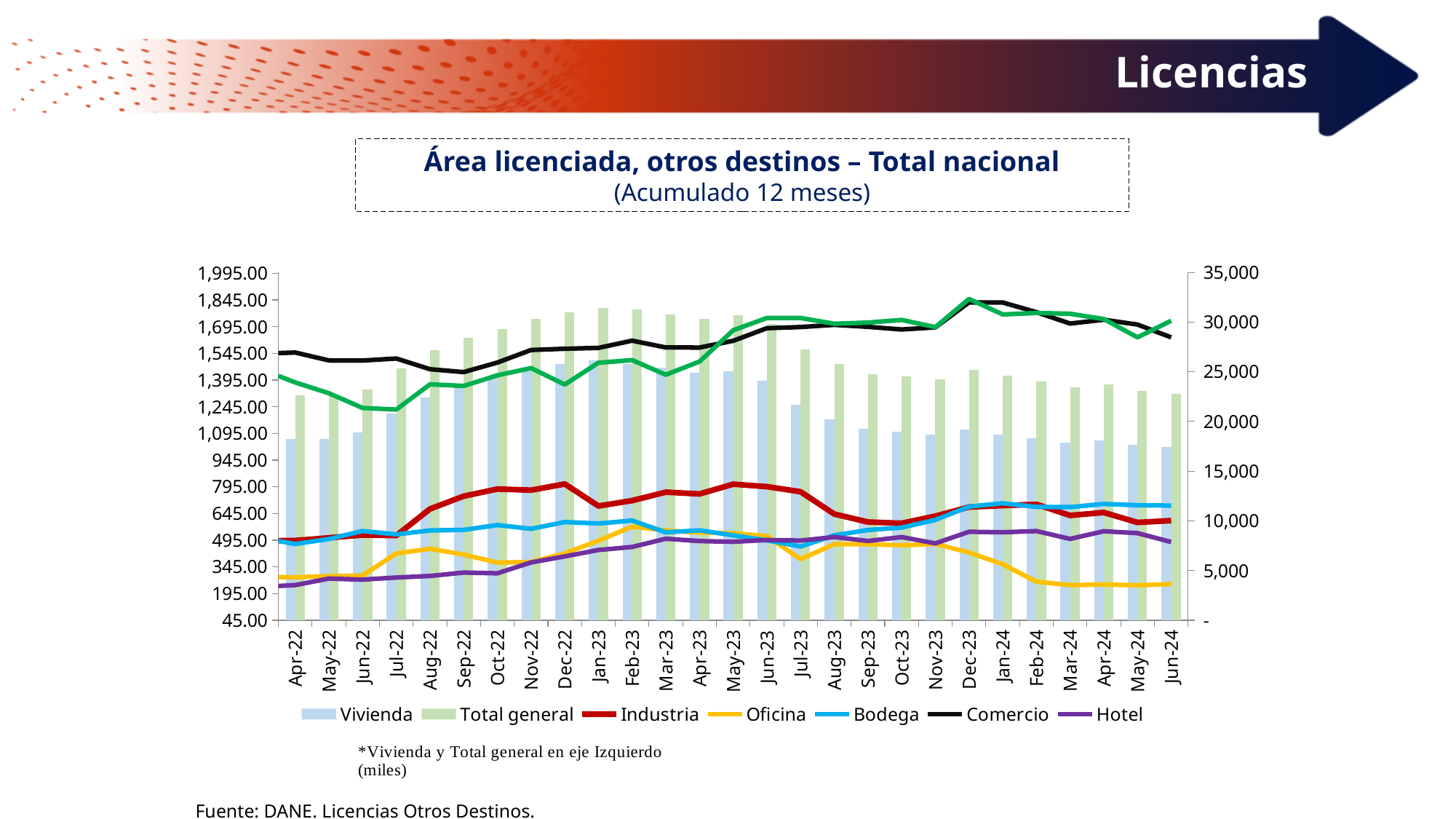
Does the Hotel line rise or fall overall from Apr-22 to Jun-24? Rises Which series are plotted on the left axis according to the note below the chart? Vivienda and Total general Is the Total general value for Jan-23 greater or less than 1,695.00? greater Is the Vivienda value for Apr-22 greater or less than 945.00? greater What kind of chart is shown on the slide? A combined bar and line chart What is the title of the chart? Área licenciada, otros destinos – Total nacional (Acumulado 12 meses) How many months are shown along the x axis? 27 How many series does the legend list? 7 Which is larger in Jun-24, the Comercio value or the Industria value? Comercio In which month is the Total general bar lowest? Apr-22 Is the Comercio value for Dec-23 greater or less than 30,000? greater